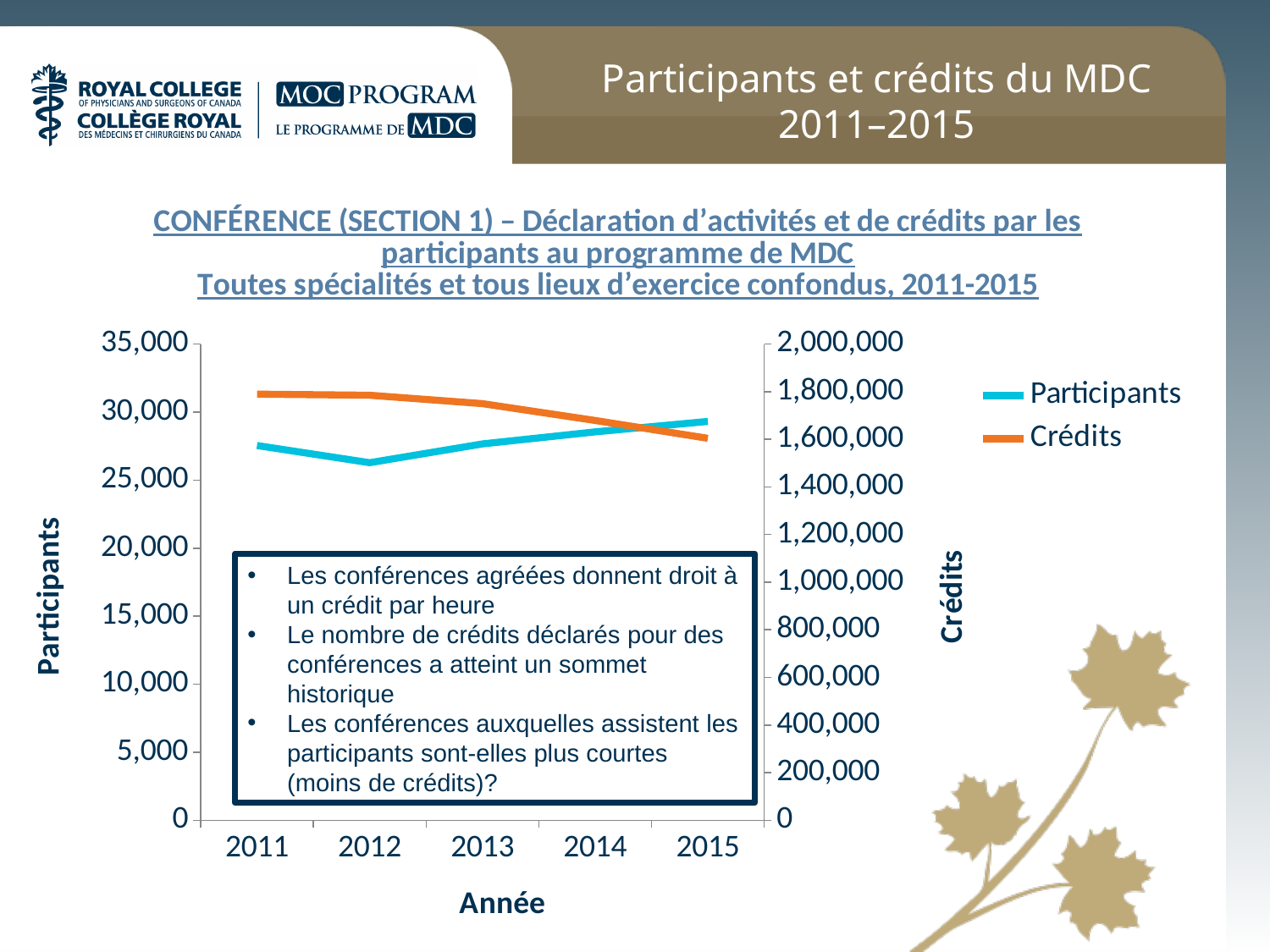
Is the Participants value for 2011 greater or less than 25,000? greater Do the Crédits values rise or fall from 2013 to 2015? fall What kind of chart is shown on the slide? line chart Is the Participants value for 2012 greater or less than 30,000? less Is the Crédits value for 2011 greater or less than 1,600,000? greater In which year is the Participants line at its lowest? 2012 In which year is the Participants line at its highest? 2015 How many series does the chart legend list? 2 In which year is the Crédits line at its lowest? 2015 Which series is drawn in orange in the chart? Crédits How many years are plotted along the x axis of the chart? 5